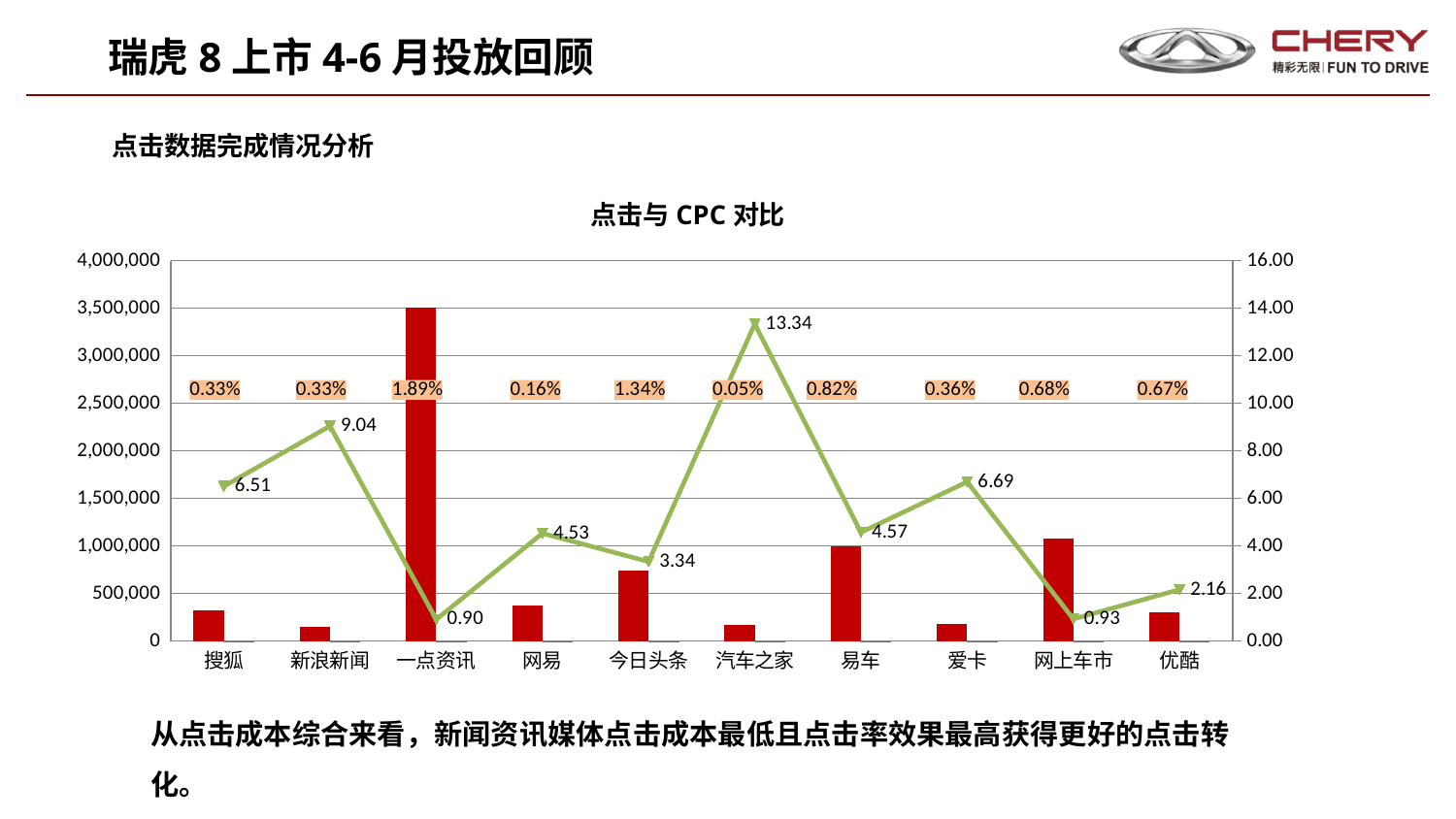
Is the bar value for 搜狐 greater or less than 500,000? less Which category has the tallest bar? 一点资讯 Which category has the highest value on the line series? 汽车之家 What is the CPC line value labelled for 汽车之家? 13.34 What is the percentage label shown above 一点资讯? 1.89% Is the bar value for 一点资讯 greater or less than 3,000,000? greater What kind of chart is this? Combination bar and line chart What is the CPC line value labelled for 一点资讯? 0.90 Which category has the lowest value on the line series? 一点资讯 Which has a higher line value, 爱卡 or 网易? 爱卡 What is the difference between the line values for 新浪新闻 and 搜狐? 2.53 How many categories are shown on the x axis? 10